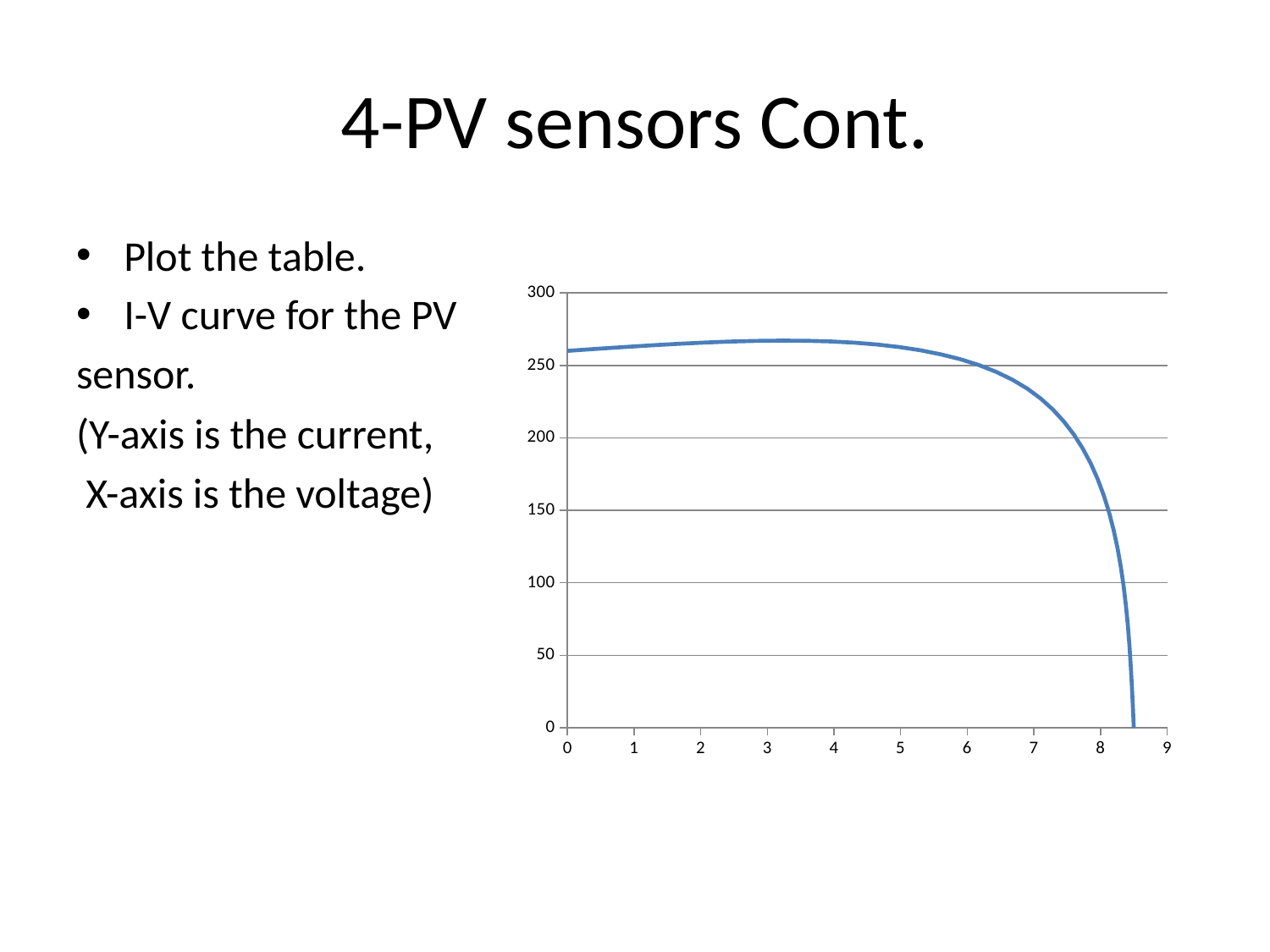
Is the value of the curve at x = 7 greater or less than 250? less Is the value of the curve at x = 7 greater or less than 200? greater Is the value of the curve at x = 8 greater or less than 200? less Is the value of the curve at x = 2 larger or smaller than the value at x = 8? larger Does the curve rise or fall as x goes from 6 to 8? fall What is the highest value shown on the x axis? 9 What kind of chart is shown on the slide? line chart What is the highest value shown on the y axis? 300